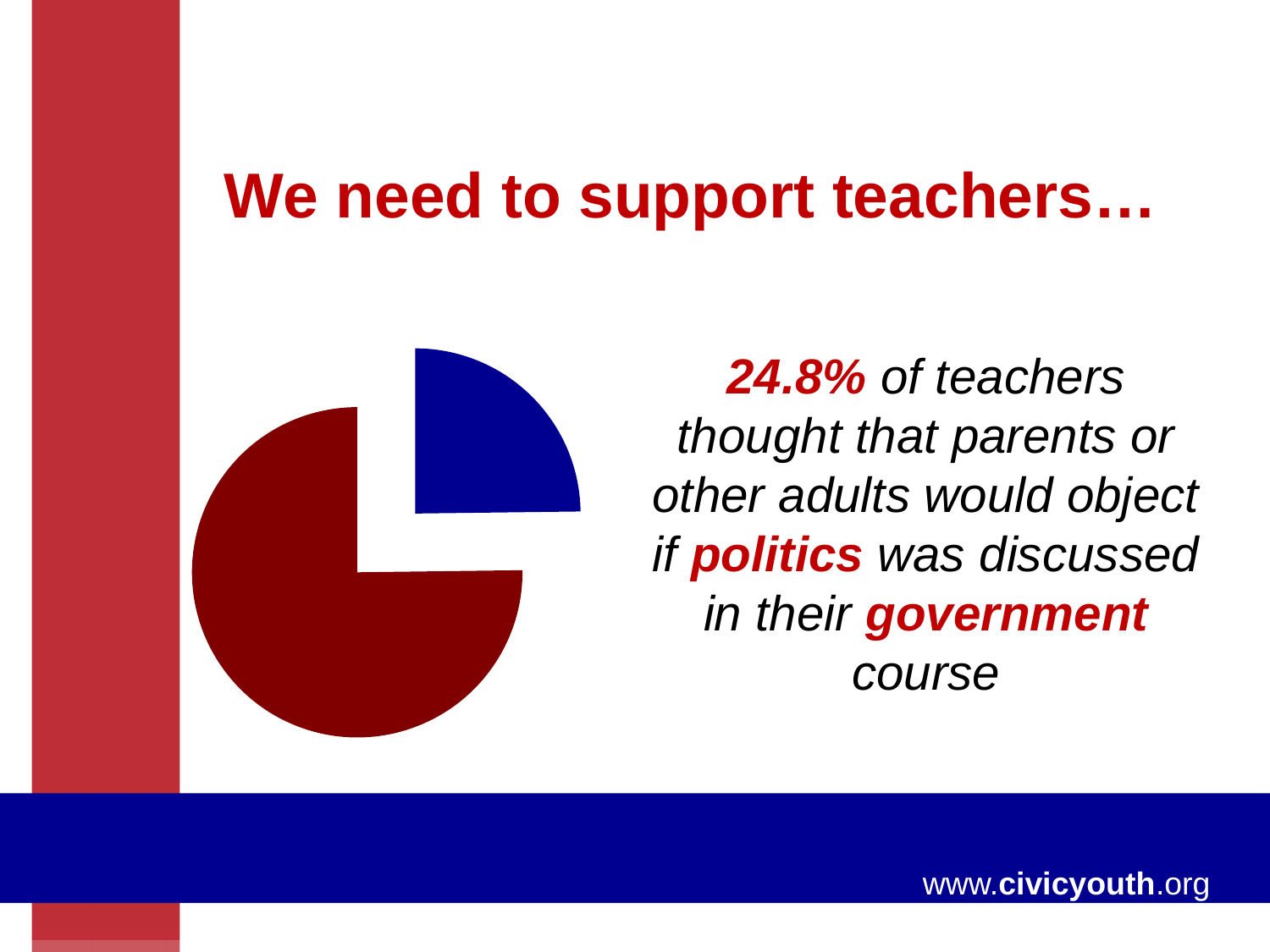
Which slice of the pie chart is pulled out (exploded) from the rest of the pie? the blue slice What kind of chart is shown on the slide? pie chart What is the title of the slide containing the pie chart? We need to support teachers… Which slice of the pie chart is larger, the blue one or the dark red one? dark red Is the share represented by the blue slice greater or less than 50%? less How many slices does the pie chart have? 2 Which slice of the pie chart is the smallest? the blue slice What share of the pie does the blue slice represent, according to the slide text? 24.8% What percentage of teachers thought parents or other adults would object if politics was discussed in their government course? 24.8% What share of the pie does the dark red slice represent? 75.2%